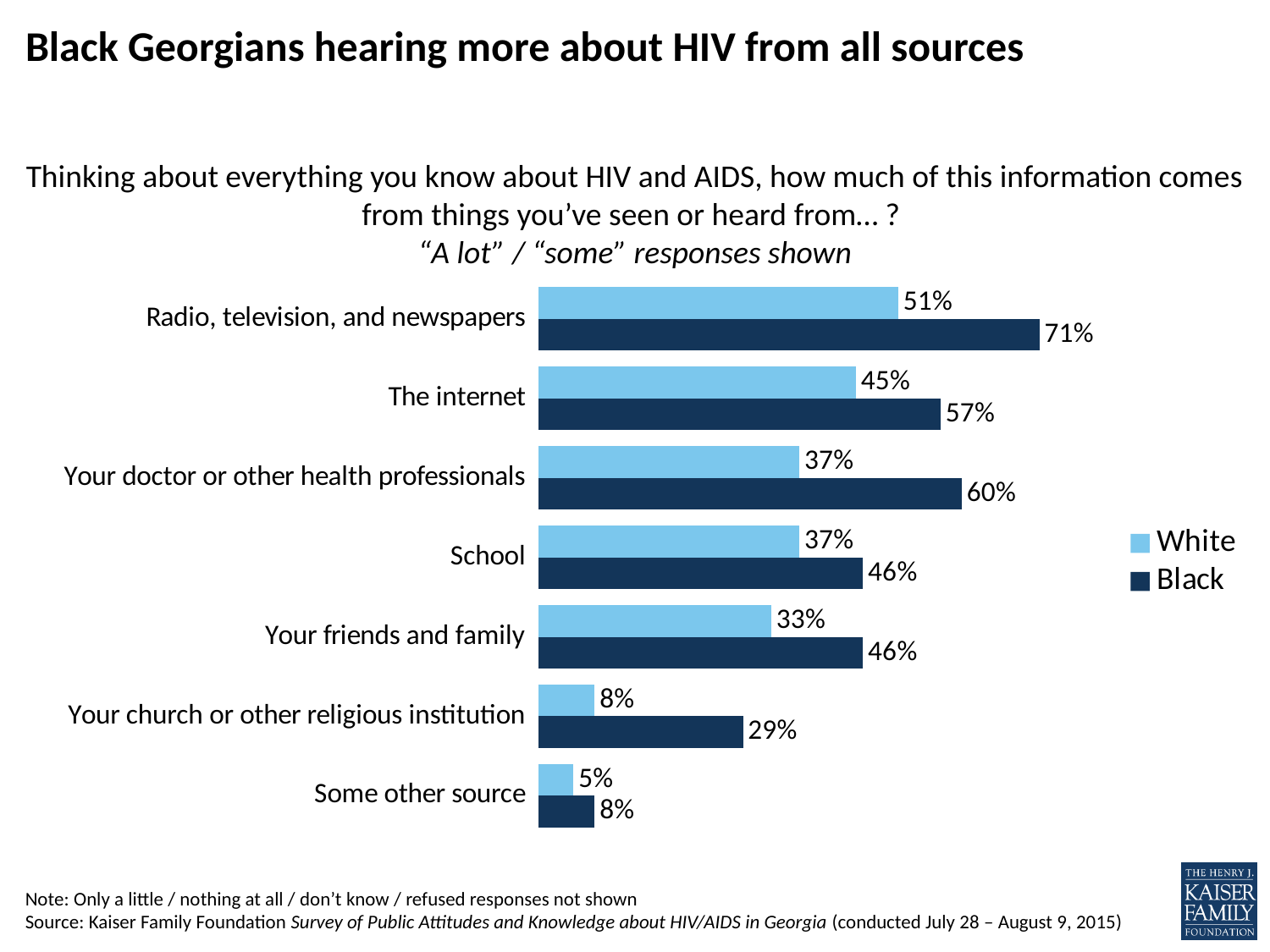
Which source has the lowest value for White respondents? Some other source What percentage of White respondents said information comes from the internet? 45% Which source has the highest value for Black respondents? Radio, television, and newspapers What kind of chart is shown on the slide? Bar chart How many sources (categories) are shown in the chart? 7 How many series does the legend list? 2 Which is larger for 'School': the White value or the Black value? Black Which series is shown in the darker blue colour? Black What is the difference between Black and White respondents for 'Your friends and family'? 13 percentage points What percentage of Black respondents said information comes from radio, television, and newspapers? 71% What is the difference between Black and White respondents for 'Your doctor or other health professionals'? 23 percentage points What is the value for Black respondents for 'Your church or other religious institution'? 29%